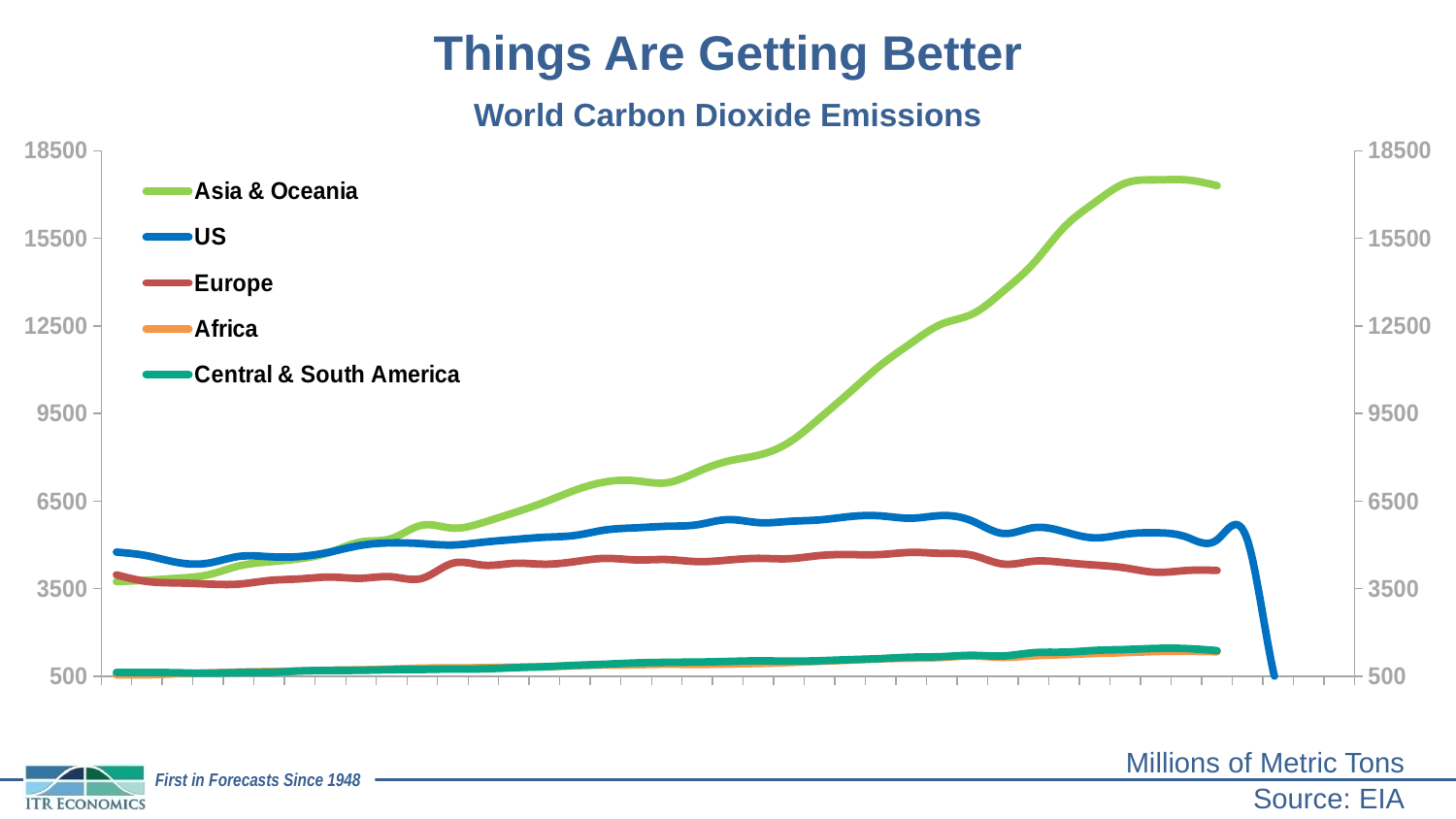
Is the highest value of the Central & South America series greater or less than 3500? less At the left end of the chart, which is larger: the US value or the Africa value? US What is the title of the chart? World Carbon Dioxide Emissions Is the peak value of the Asia & Oceania series greater or less than 15500? greater What kind of chart is shown on the slide? line chart Which series reaches the highest value on the chart? Asia & Oceania Does the Asia & Oceania series generally rise or fall from left to right? rise At the right end of the chart, which is larger: the Asia & Oceania value or the Europe value? Asia & Oceania How many series does the legend list? 5 What unit of measurement is stated for the chart values? Millions of Metric Tons Is the highest value of the Europe series greater or less than 6500? less